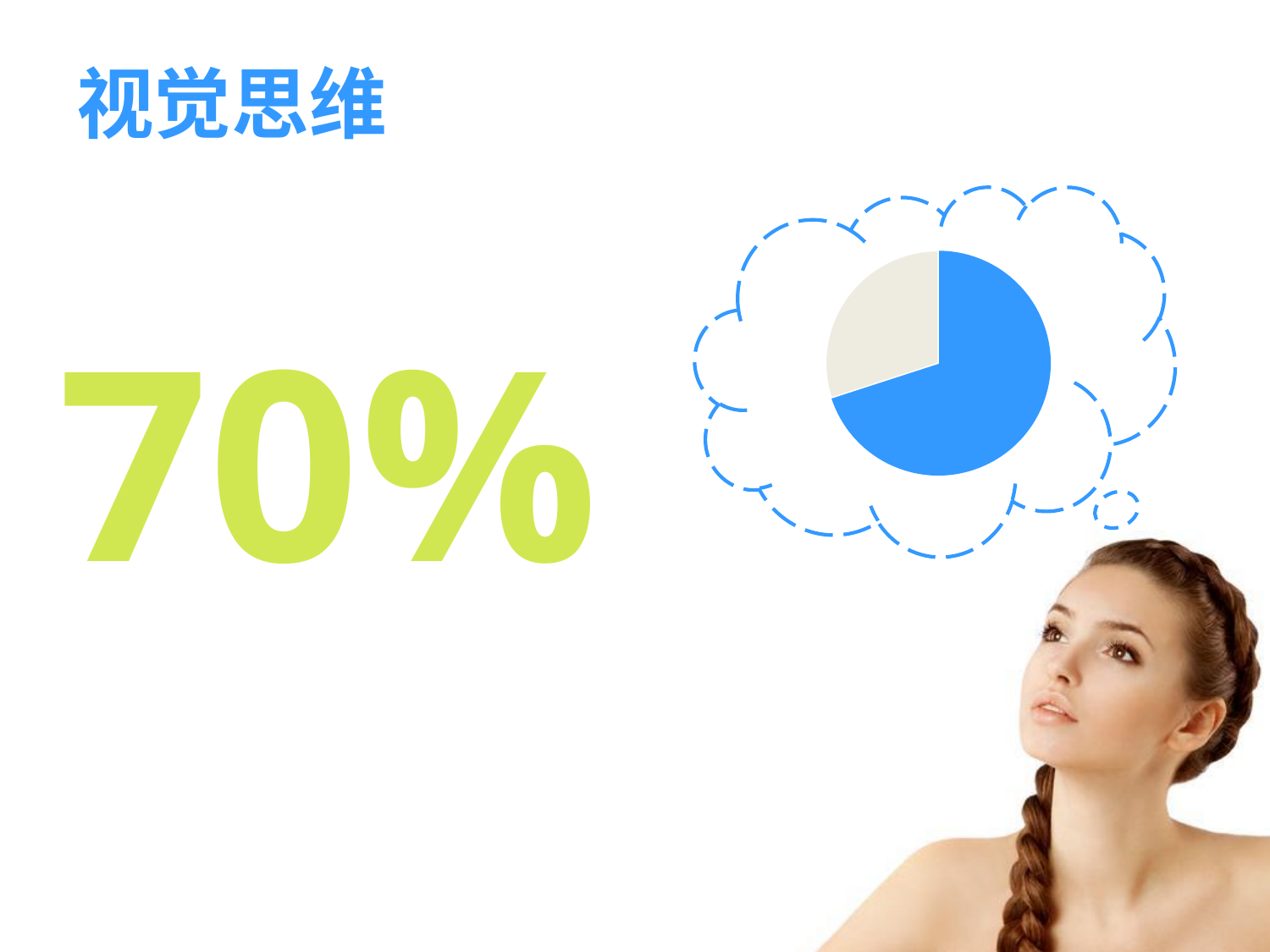
What is the title text at the top of the slide? 视觉思维 Which slice of the pie chart is larger, the blue one or the grey one? the blue one Is the grey slice of the pie chart greater or less than half of the pie? less What kind of chart is shown inside the thought bubble? pie chart What share of the pie does the blue slice represent, according to the figure printed on the slide? 70% How many slices does the pie chart have? 2 What colour is the largest slice of the pie chart? blue Is the blue slice of the pie chart greater or less than half of the pie? greater